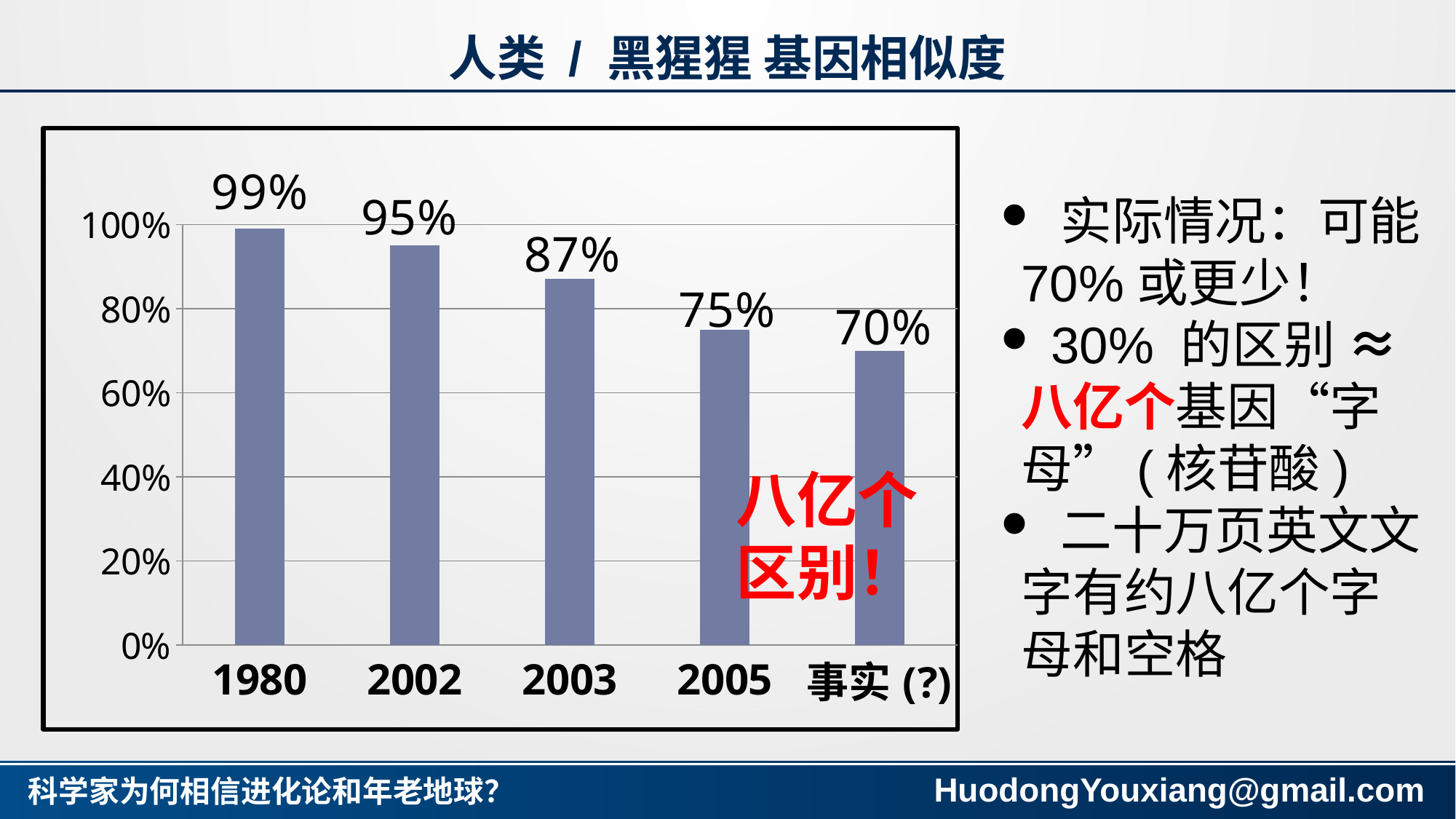
How many categories are shown on the x axis? 5 What is the value for 2003? 87% Is the value for 2005 greater or less than 80%? less What kind of chart is shown on the slide? bar chart What is the difference between the values for 2002 and 2003? 8% What is the value for 事实 (?)? 70% Which category has the lowest value? 事实 (?) Do the values rise or fall from left to right along the x axis? fall What is the difference between the values for 1980 and 2005? 24% What is the value for 1980? 99% Which category has the highest value? 1980 Which is larger, the value for 2002 or the value for 2005? 2002